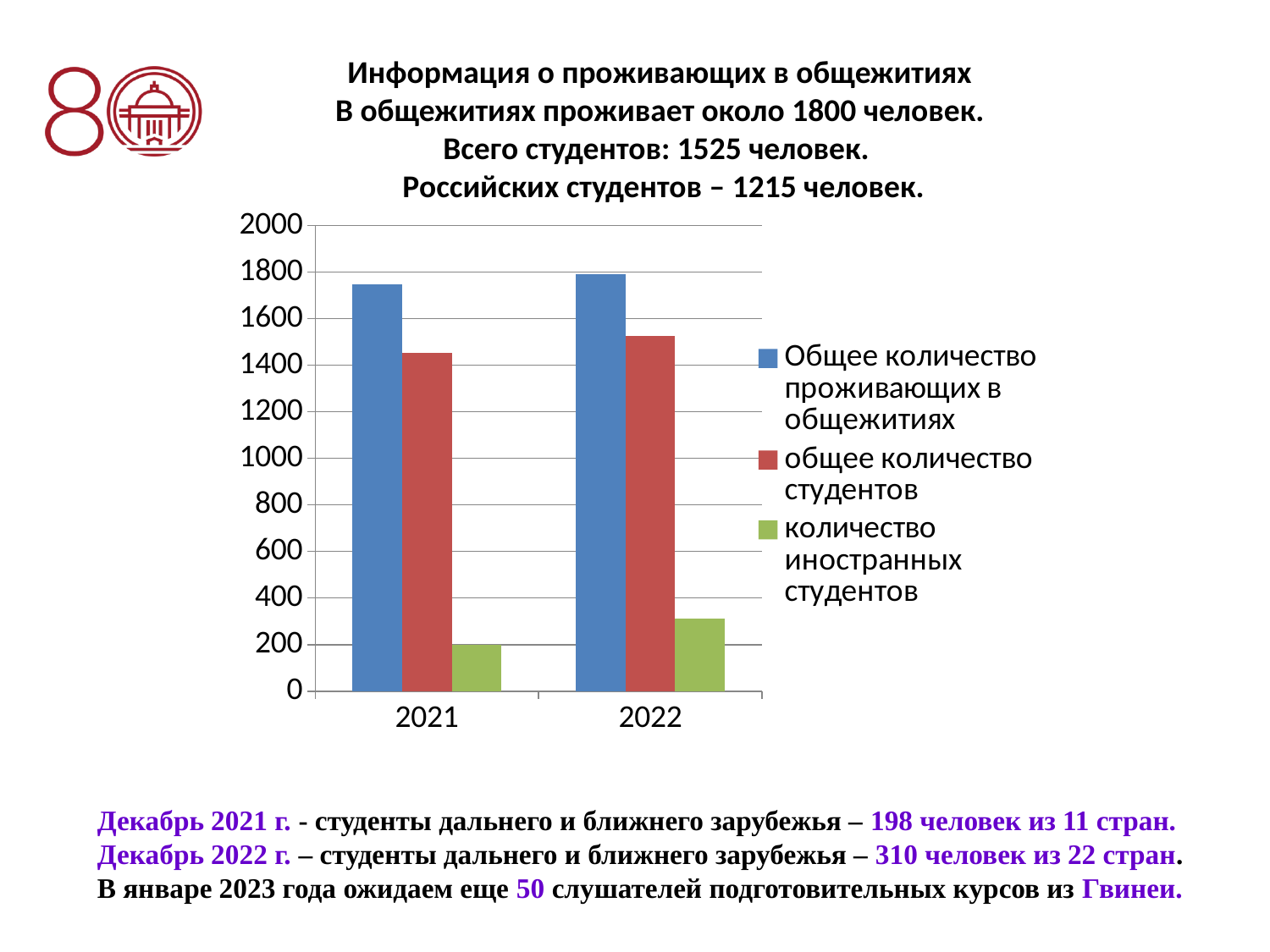
Which year has the larger value for 'количество иностранных студентов', 2021 or 2022? 2022 Is the value for 'Общее количество проживающих в общежитиях' in 2021 greater or less than 1600? greater Is the value for 'количество иностранных студентов' in 2022 greater or less than 400? less Does the value for 'количество иностранных студентов' rise or fall from 2021 to 2022? rise Is the value for 'общее количество студентов' in 2021 greater or less than 1400? greater Which series has the lowest value in 2022? количество иностранных студентов What colour represents 'количество иностранных студентов' in the legend? green How many categories are shown on the x axis? 2 What kind of chart is shown on the slide? bar chart How many series does the legend list? 3